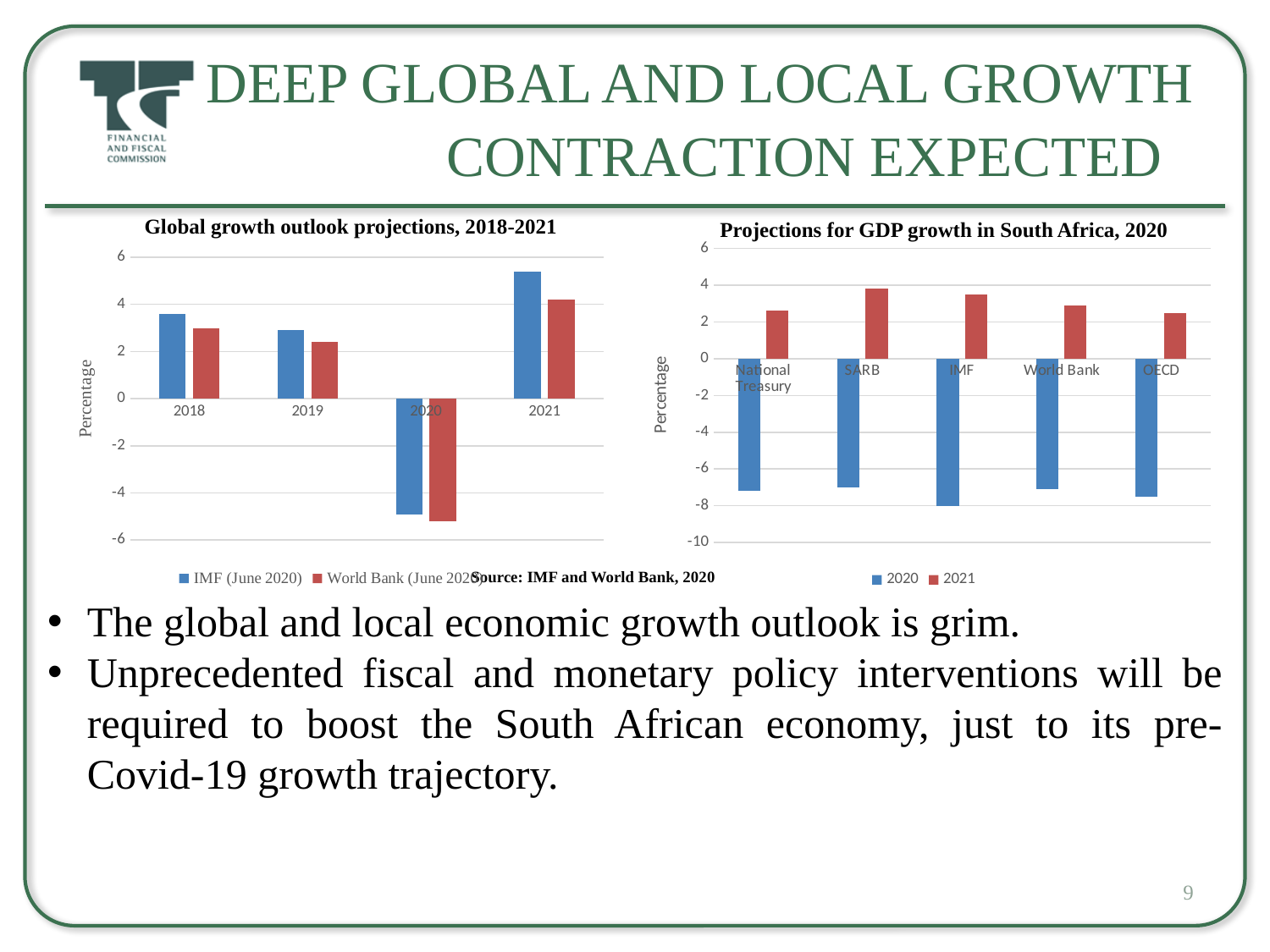
How many years are shown on the x axis of the 'Global growth outlook projections, 2018-2021' chart? 4 In the 'Projections for GDP growth in South Africa, 2020' chart, which is larger: the 2021 value for SARB or the 2021 value for OECD? SARB What kind of chart is the 'Global growth outlook projections, 2018-2021' chart? Bar chart In the 'Projections for GDP growth in South Africa, 2020' chart, is the 2020 value for IMF greater or less than -6? less In the 'Projections for GDP growth in South Africa, 2020' chart, is the 2021 value for SARB greater or less than 2? greater In the 'Global growth outlook projections, 2018-2021' chart, which year has the lowest World Bank (June 2020) value? 2020 How many institutions are shown on the x axis of the 'Projections for GDP growth in South Africa, 2020' chart? 5 How many series does the legend of the 'Projections for GDP growth in South Africa, 2020' chart list? 2 In the 'Global growth outlook projections, 2018-2021' chart, is the IMF (June 2020) value for 2021 greater or less than 4? greater What are the two series listed in the legend of the 'Global growth outlook projections, 2018-2021' chart? IMF (June 2020) and World Bank (June 2020) In the 'Global growth outlook projections, 2018-2021' chart, which year has the highest IMF (June 2020) value? 2021